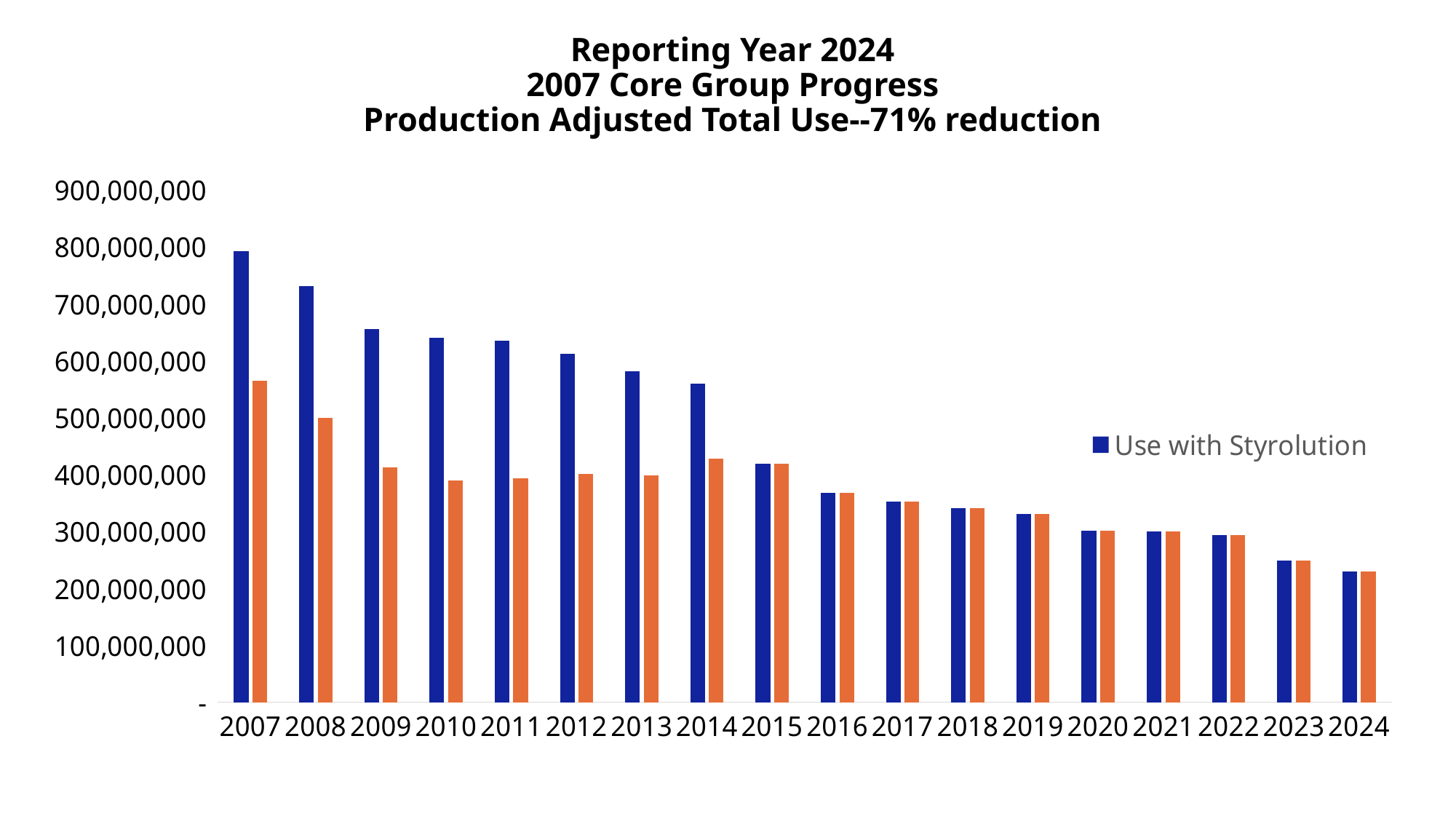
How many years are shown along the x axis of the chart? 18 What kind of chart is shown on the slide? Bar chart Which year has the lowest value for Use with Styrolution? 2024 In 2007, which bar is taller: the blue Use with Styrolution bar or the orange bar? The blue Use with Styrolution bar Do the values for Use with Styrolution rise or fall from 2007 to 2024? Fall Is the value for Use with Styrolution in 2024 greater or less than 300,000,000? less Which year has the highest value for Use with Styrolution? 2007 How many series does the chart's legend list? 1 Is the value for Use with Styrolution in 2007 greater or less than 700,000,000? greater Is the value for Use with Styrolution in 2016 greater or less than 400,000,000? less According to the chart title, what percentage reduction in Production Adjusted Total Use is reported? 71% What is the series name shown in the chart's legend? Use with Styrolution